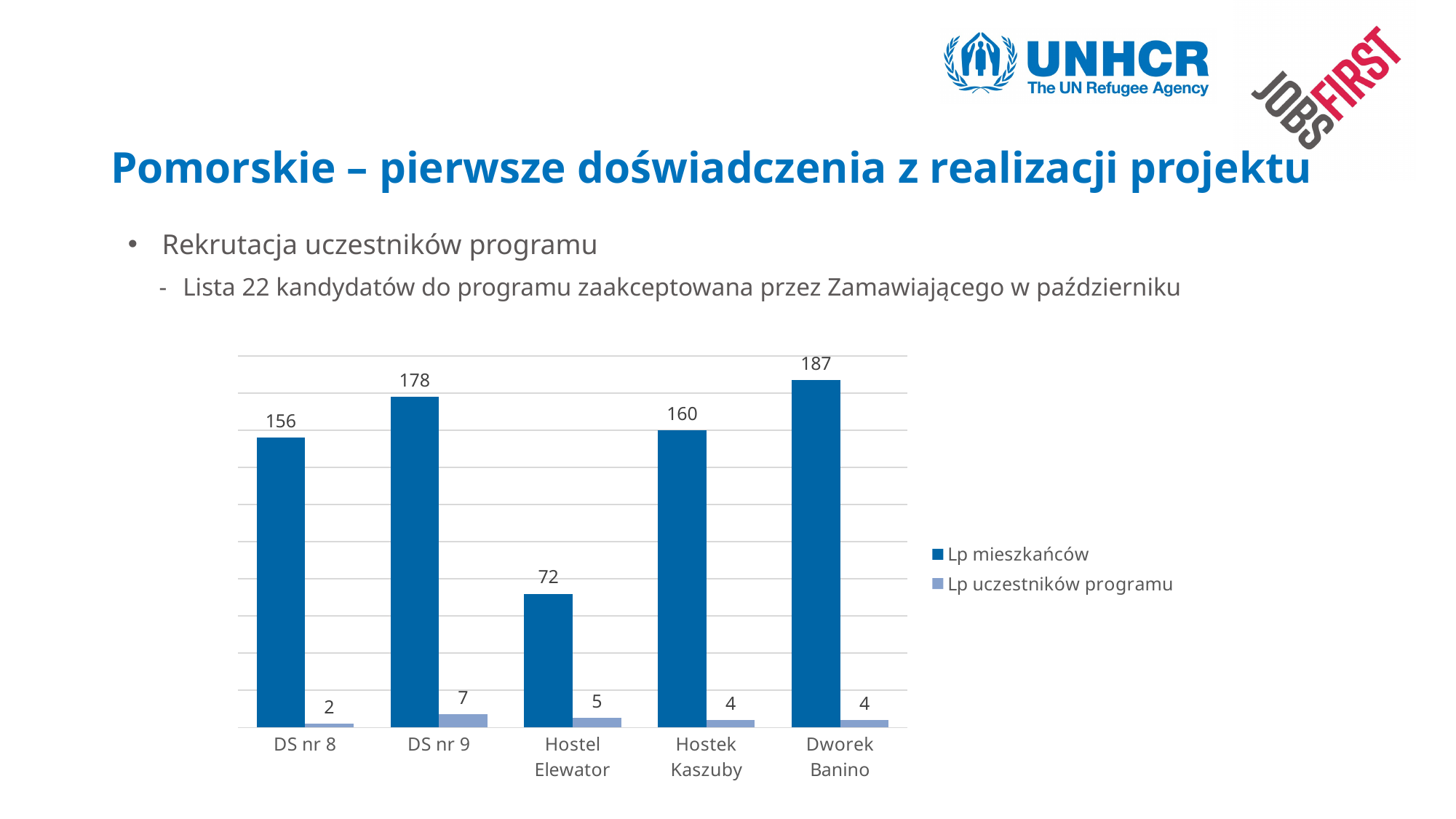
What is the value of Lp uczestników programu for Hostel Elewator? 5 What is the total of Lp uczestników programu across all five categories? 22 What is the value of Lp mieszkańców for DS nr 9? 178 Which is larger: Lp mieszkańców for DS nr 9 or for Hostek Kaszuby? DS nr 9 Which category has the lowest value for Lp uczestników programu? DS nr 8 How many categories are shown on the x axis of the chart? 5 Which category has the highest value for Lp mieszkańców? Dworek Banino What is the value of Lp mieszkańców for Hostek Kaszuby? 160 How many series does the legend list? 2 What is the difference between Lp mieszkańców for Dworek Banino and DS nr 8? 31 Which category has the lowest value for Lp mieszkańców? Hostel Elewator What kind of chart is shown on the slide? Bar chart